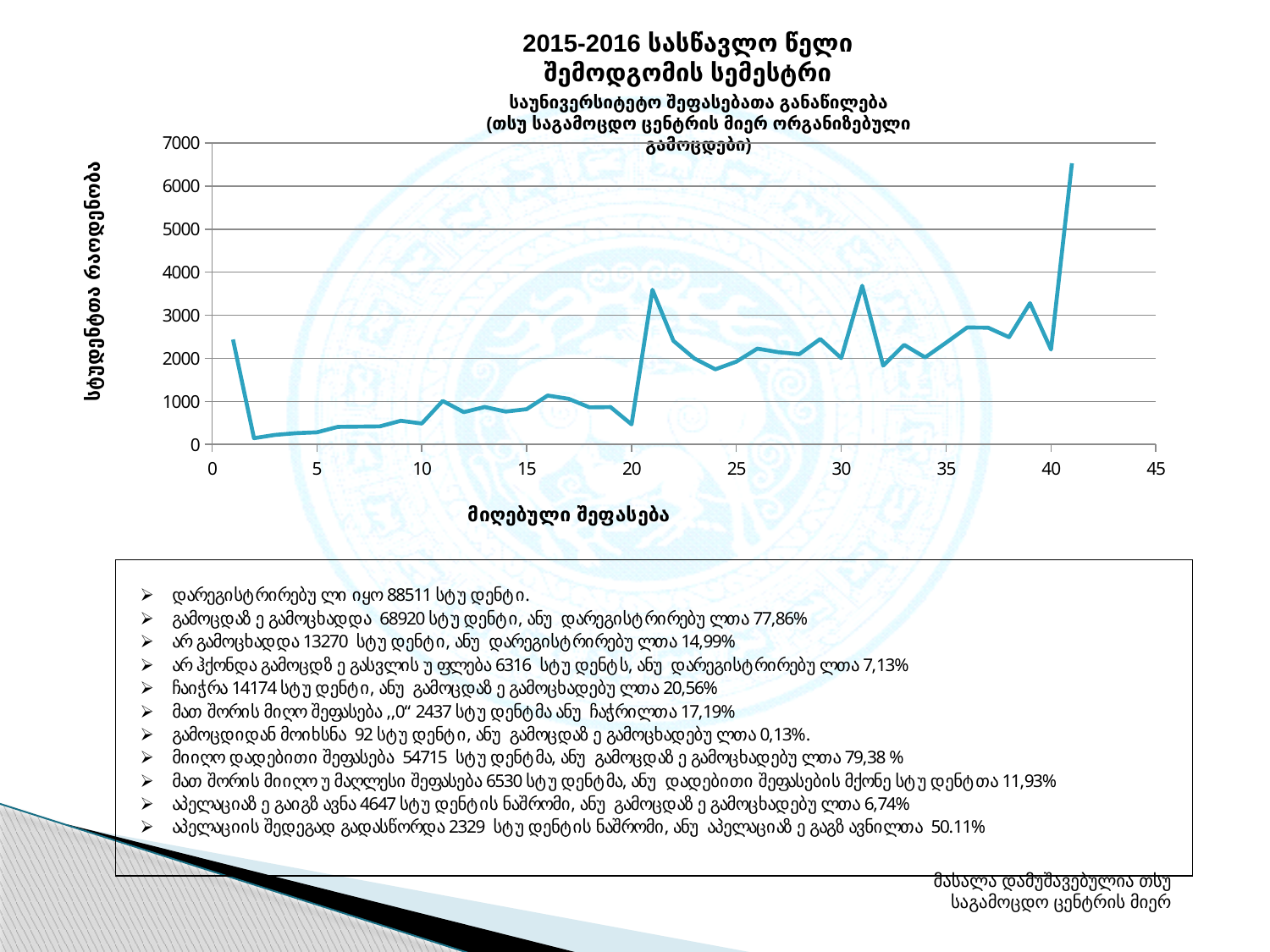
What is the label of the vertical axis of the chart? სტუდენტთა რაოდენობა What is the highest value shown on the vertical axis of the chart? 7000 Overall, do the values rise or fall as the score on the x axis increases from 20 to 41? rise Is the value at the final point of the line (around x = 41) greater or less than 6000? greater Is the value at x = 1 greater or less than 2000? greater Which is larger, the value at x = 21 or the value at x = 20? x = 21 What is the label of the horizontal axis of the chart? მიღებული შეფასება What kind of chart is shown on the slide? line chart